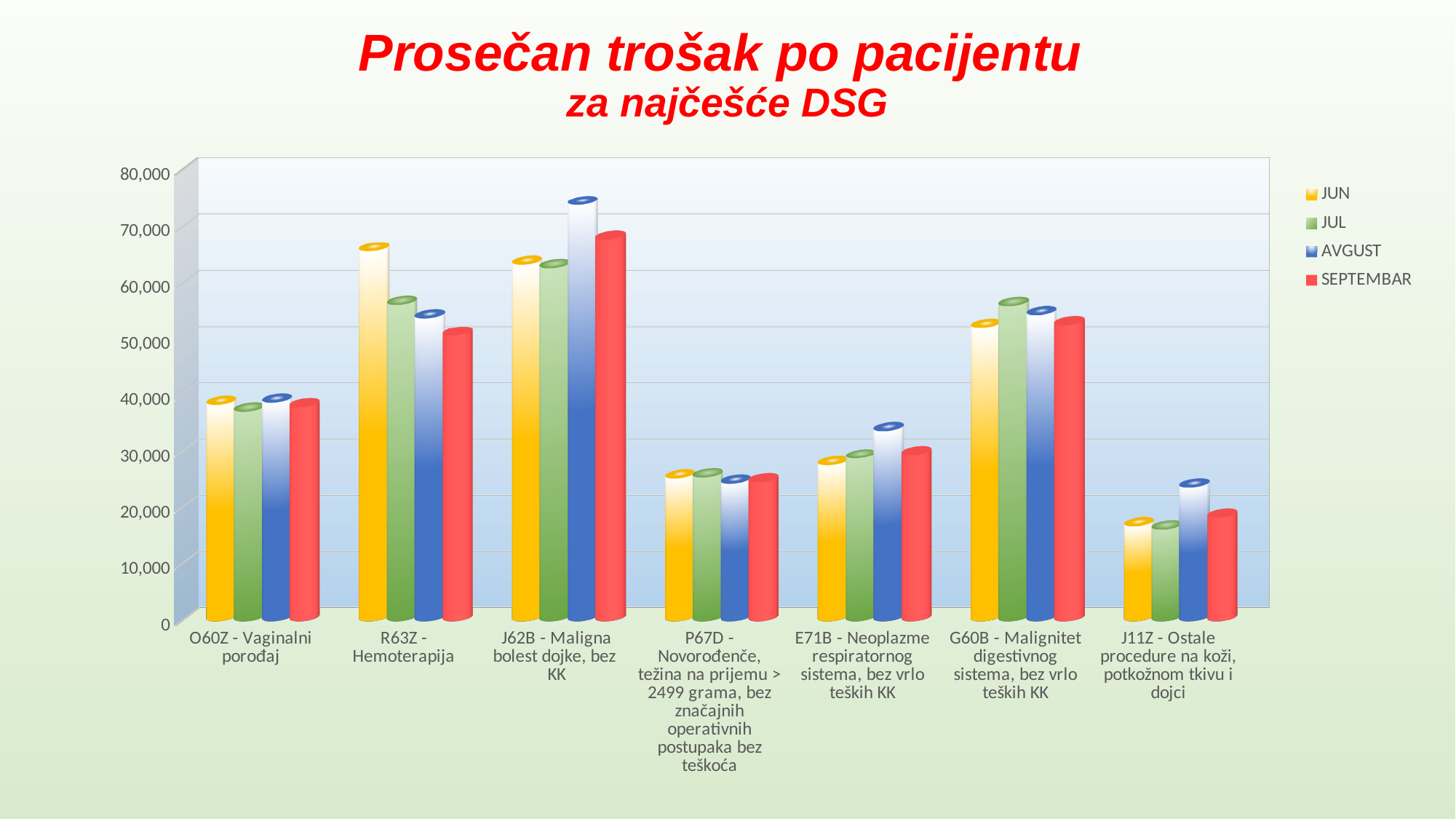
Is the JUL value for G60B - Malignitet digestivnog sistema, bez vrlo teških KK greater or less than 50,000? greater Which series is shown in red in the legend? SEPTEMBAR Is the JUN value for J11Z - Ostale procedure na koži, potkožnom tkivu i dojci greater or less than 20,000? less How many series does the legend list? 4 How many DSG categories are shown on the x axis? 7 For R63Z - Hemoterapija, which is larger: the JUN value or the SEPTEMBAR value? JUN Is the JUN value for R63Z - Hemoterapija greater or less than 60,000? greater Which category has the lowest JUN value? J11Z - Ostale procedure na koži, potkožnom tkivu i dojci What kind of chart is shown on the slide? bar chart Which category has the highest AVGUST value? J62B - Maligna bolest dojke, bez KK For R63Z - Hemoterapija, do the values rise or fall from JUN to SEPTEMBAR? fall